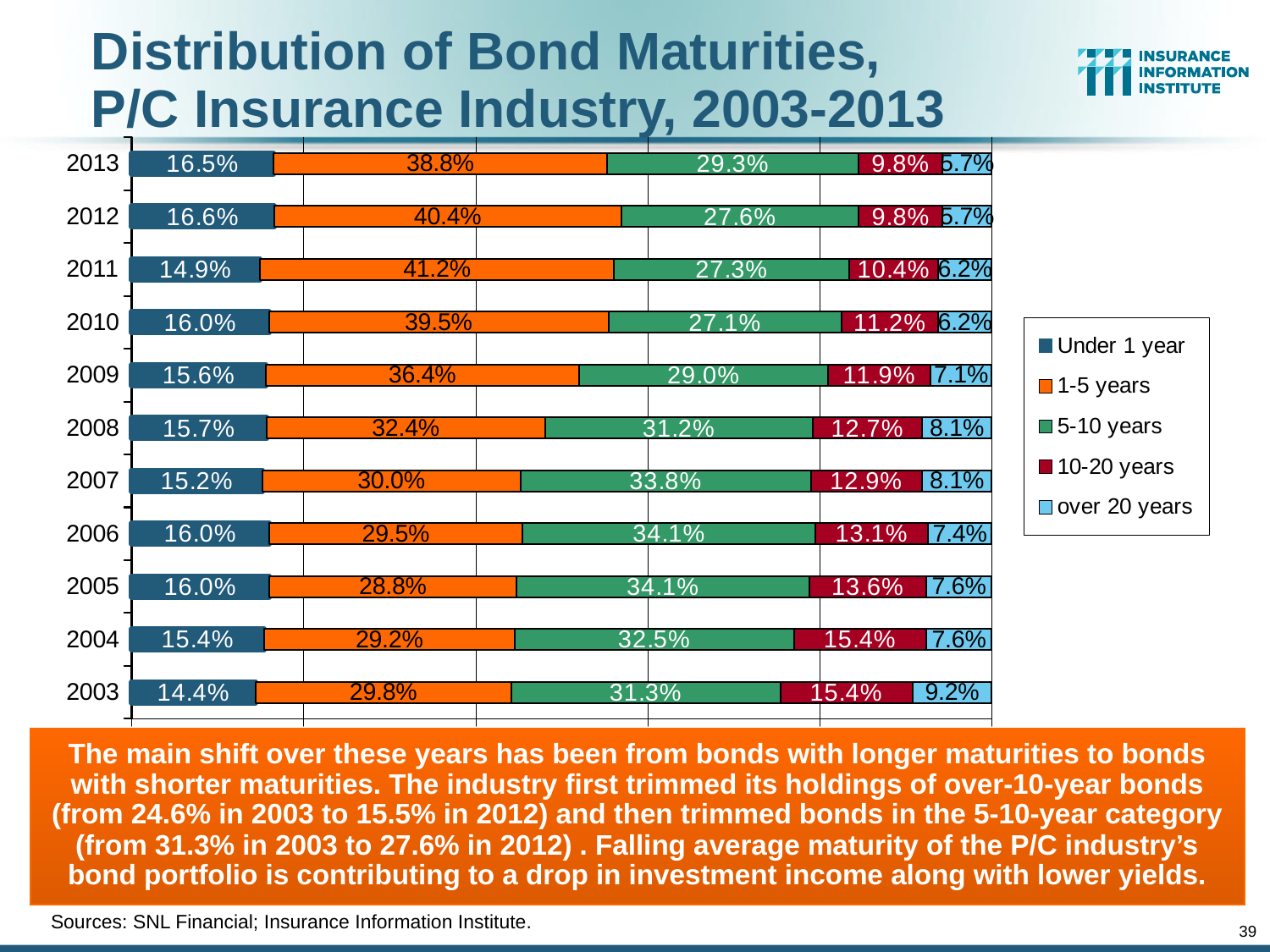
What is the difference between the 5-10 years share in 2003 and in 2012? 3.7 percentage points What percentage of bonds had a 1-5 year maturity in 2013? 38.8% What was the share of bonds with maturities over 20 years in 2003? 9.2% In which year was the Under 1 year share the lowest? 2003 In which year was the 1-5 years share the highest? 2011 What percentage of bonds had a 10-20 year maturity in 2010? 11.2% What type of chart is shown on the slide? Stacked bar chart Which is larger: the 1-5 years share in 2013 or the 5-10 years share in 2013? 1-5 years share in 2013 Did the share of bonds with 10-20 year maturities rise or fall from 2003 to 2013? Fall How many maturity categories does the legend list? 5 How many years are shown on the chart? 11 Which legend entry is shown in orange? 1-5 years